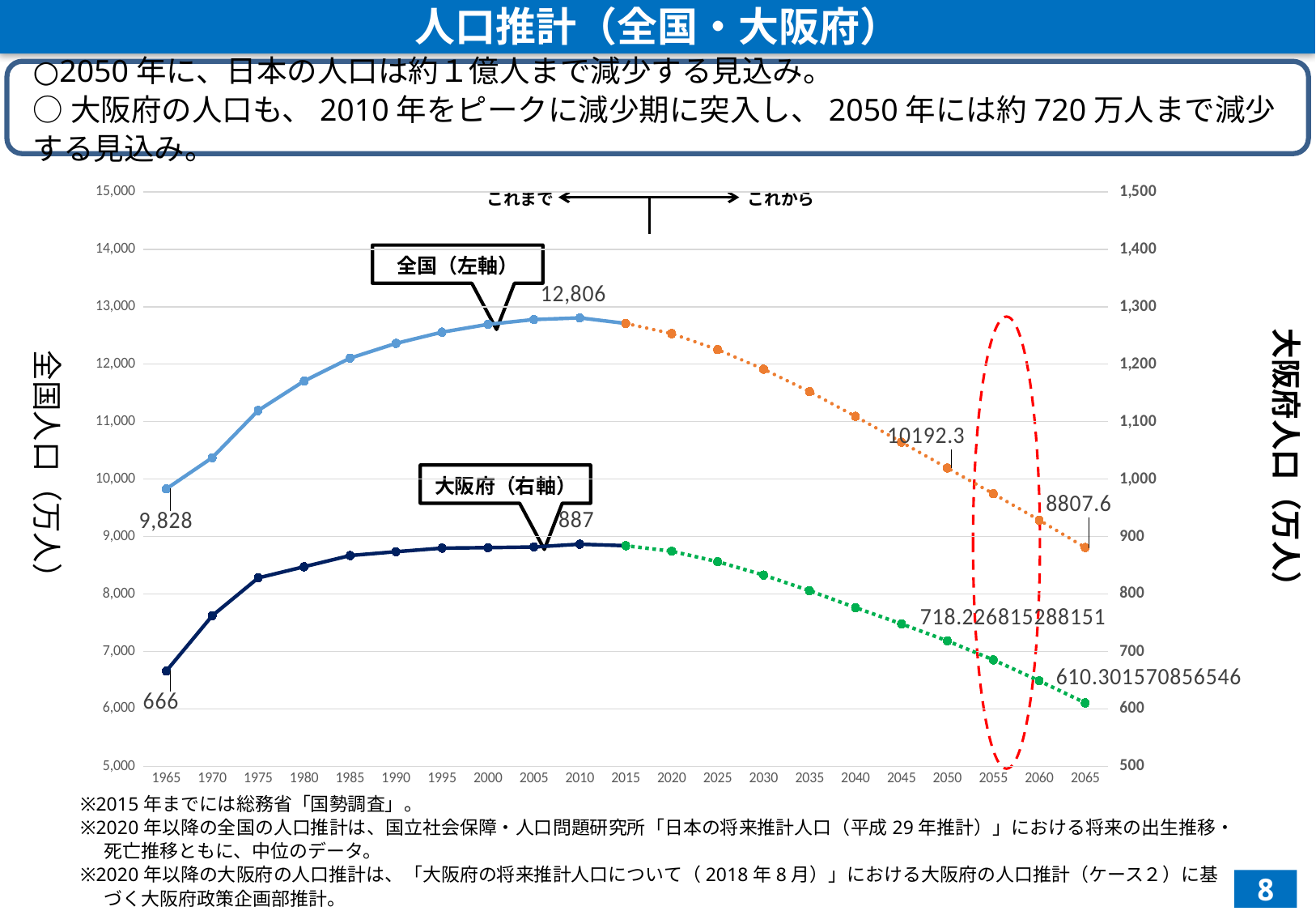
What kind of chart is shown on the slide? Line chart In which year does the national population (全国) line reach its highest point? 2010 What is the Osaka Prefecture (大阪府) population value labelled for 2010? 887 What is the Osaka Prefecture (大阪府) population value labelled for 1965? 666 What is the difference between the national population (全国) in 2010 and in 1965? 2,978 How many years are shown on the x axis? 21 What is the national population (全国) value labelled for 1965? 9,828 What is the national population (全国) value labelled for 2065? 8807.6 What is the national population (全国) value labelled for 2010? 12,806 Is the national population (全国) value for 2030 greater or less than 12,000 on the left axis? less What is the difference between the Osaka Prefecture (大阪府) population in 2010 and in 1965? 221 What is the national population (全国) value labelled for 2050? 10192.3